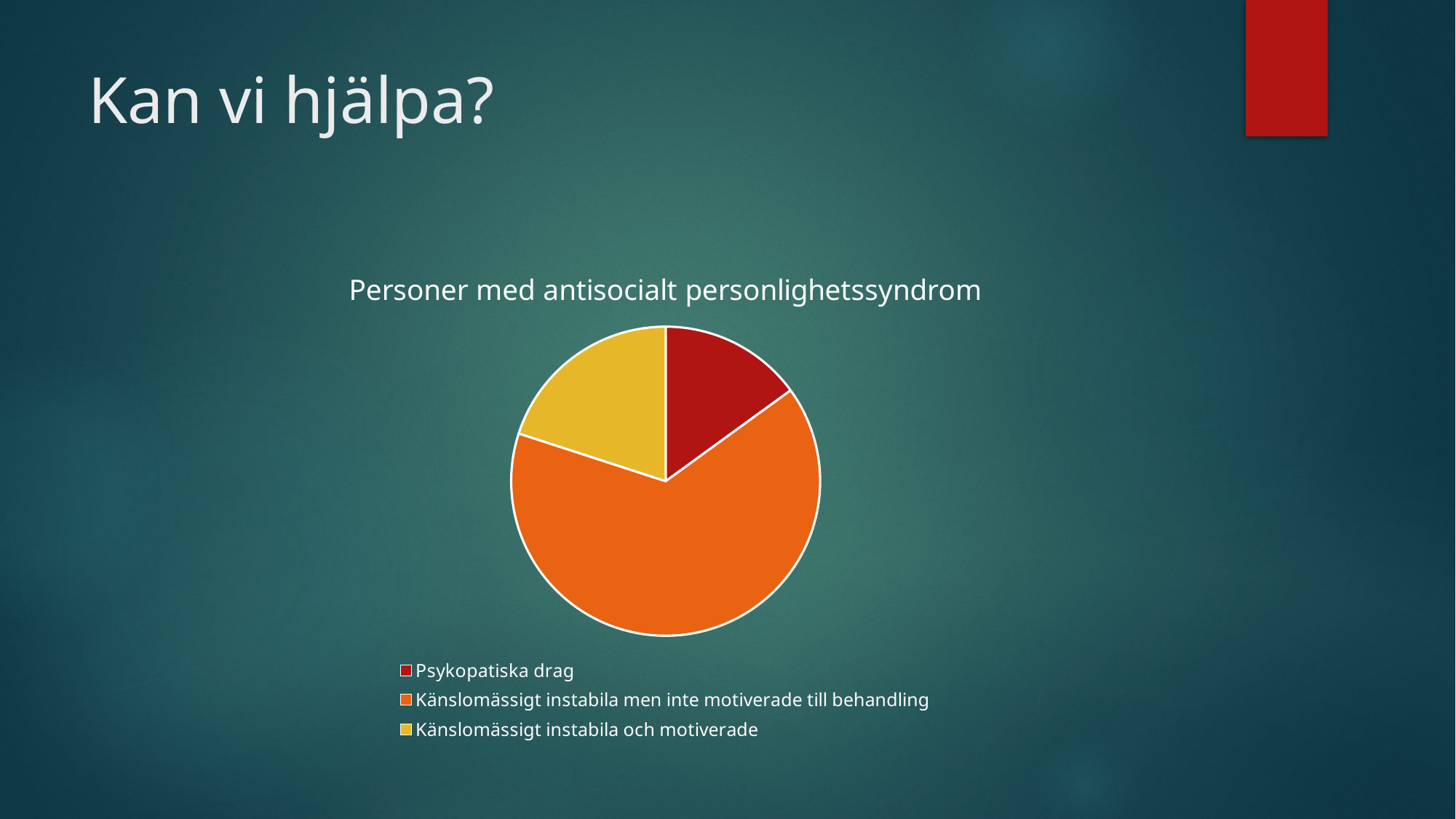
What kind of chart is shown on the slide? pie chart How many slices does the pie chart have? 3 Which slice is larger: Känslomässigt instabila och motiverade or Psykopatiska drag? Känslomässigt instabila och motiverade What is the title of the chart? Personer med antisocialt personlighetssyndrom What colour is the slice for Psykopatiska drag? red Which slice is larger: Känslomässigt instabila och motiverade or Känslomässigt instabila men inte motiverade till behandling? Känslomässigt instabila men inte motiverade till behandling Which category has the largest slice of the pie? Känslomässigt instabila men inte motiverade till behandling Which slice is larger: Psykopatiska drag or Känslomässigt instabila men inte motiverade till behandling? Känslomässigt instabila men inte motiverade till behandling How many entries does the legend list? 3 Which category has the smallest slice of the pie? Psykopatiska drag